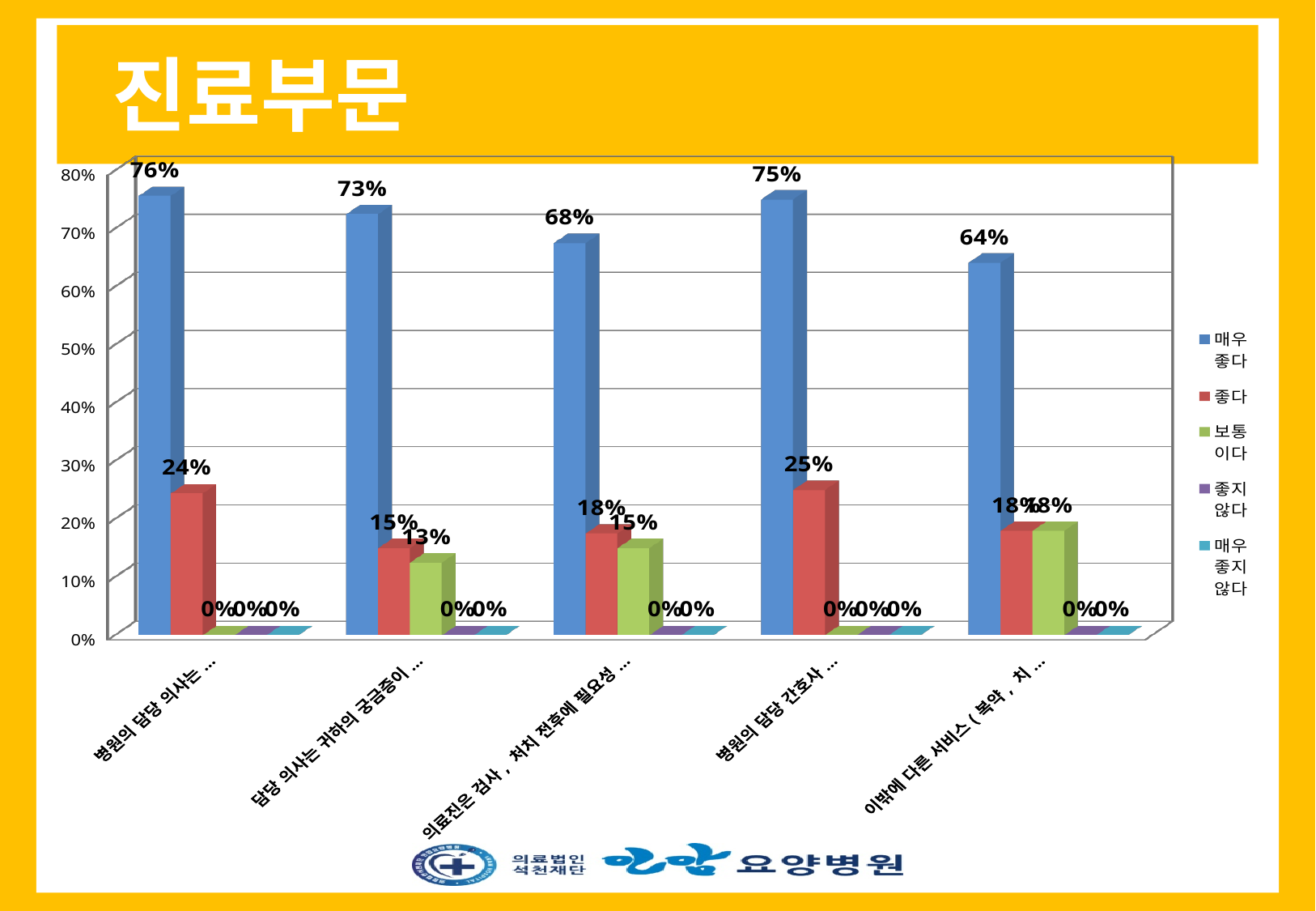
How many series does the legend list? 5 How many categories are shown on the x axis? 5 What is the difference between the 매우 좋다 values of the first category (76%) and the fifth category (64%)? 12% What is the value of 보통이다 for the second category (담당 의사는 귀하의 궁금증이 ...)? 13% What is the value of 좋지 않다 for the third category (의료진은 검사, 처치 전후에 필요성 ...)? 0% What is the title of the slide above the chart? 진료부문 Which category has the lowest 매우 좋다 value? 이밖에 다른 서비스 (복약, 치 ... (the fifth category) Which category has the highest 매우 좋다 value? 병원의 담당 의사는 ... (the first category) What kind of chart is shown on the slide? bar chart What is the value of 좋다 for the fourth category (병원의 담당 간호사 ...)? 25% Which is larger: the 좋다 value for the first category or the 좋다 value for the second category? the first category (24%) What is the value of 매우 좋다 for the first category (병원의 담당 의사는 ...)? 76%